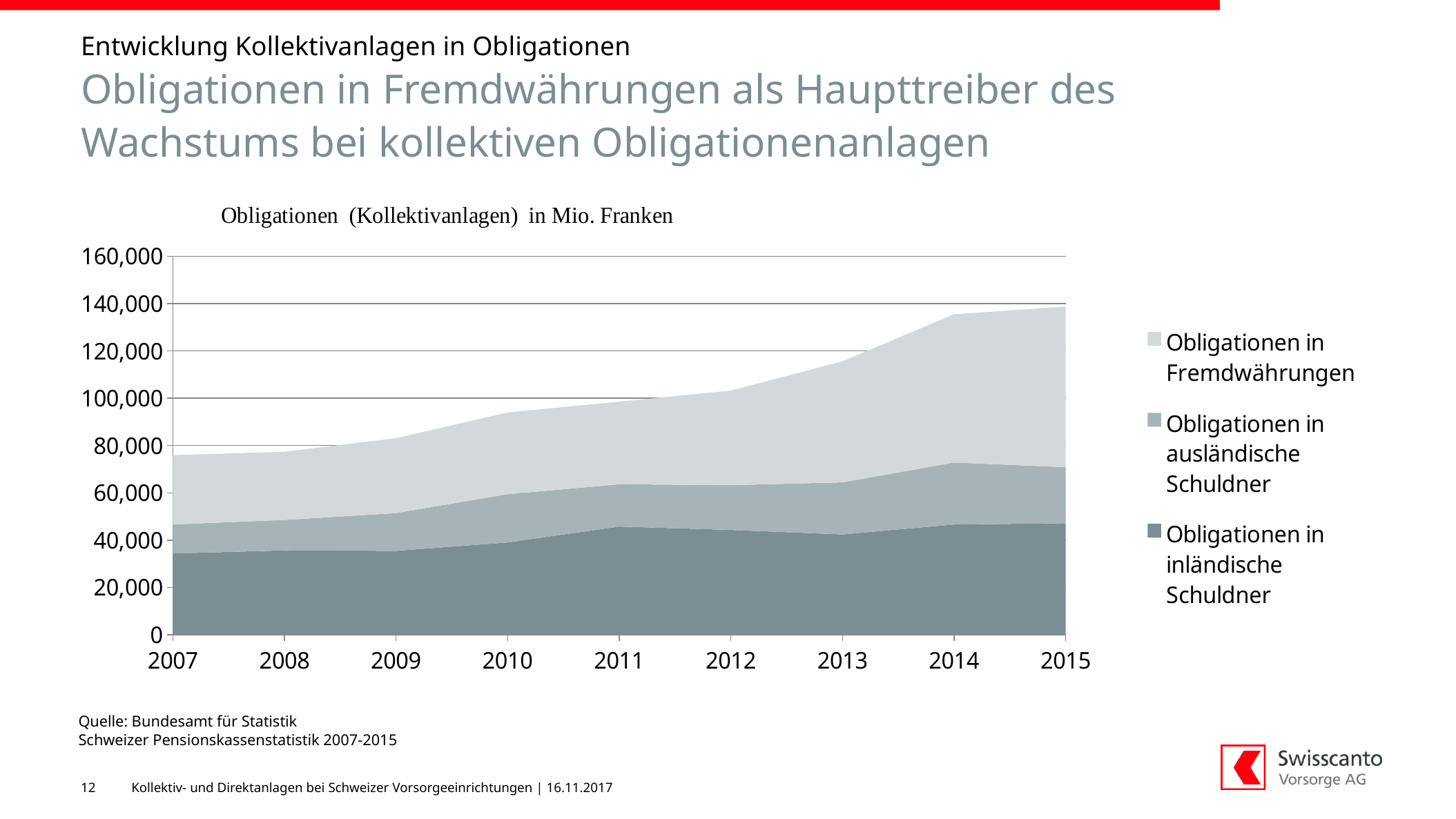
What kind of chart is shown on the slide? stacked area chart Which series is listed first (at the top) in the chart legend? Obligationen in Fremdwährungen What is the title of the chart? Obligationen (Kollektivanlagen) in Mio. Franken How many years are shown along the x axis of the chart? 9 Does the total of all three series rise or fall from 2007 to 2015? rise Is the stacked total for 2015 greater or less than 120,000? greater In which year is the stacked total of all series lowest? 2007 Which year has the larger stacked total, 2007 or 2015? 2015 Is the value for Obligationen in inländische Schuldner in 2007 greater or less than 40,000? less How many series does the chart legend list? 3 In which year is the stacked total of all series highest? 2015 Is the stacked total for 2007 greater or less than 80,000? less